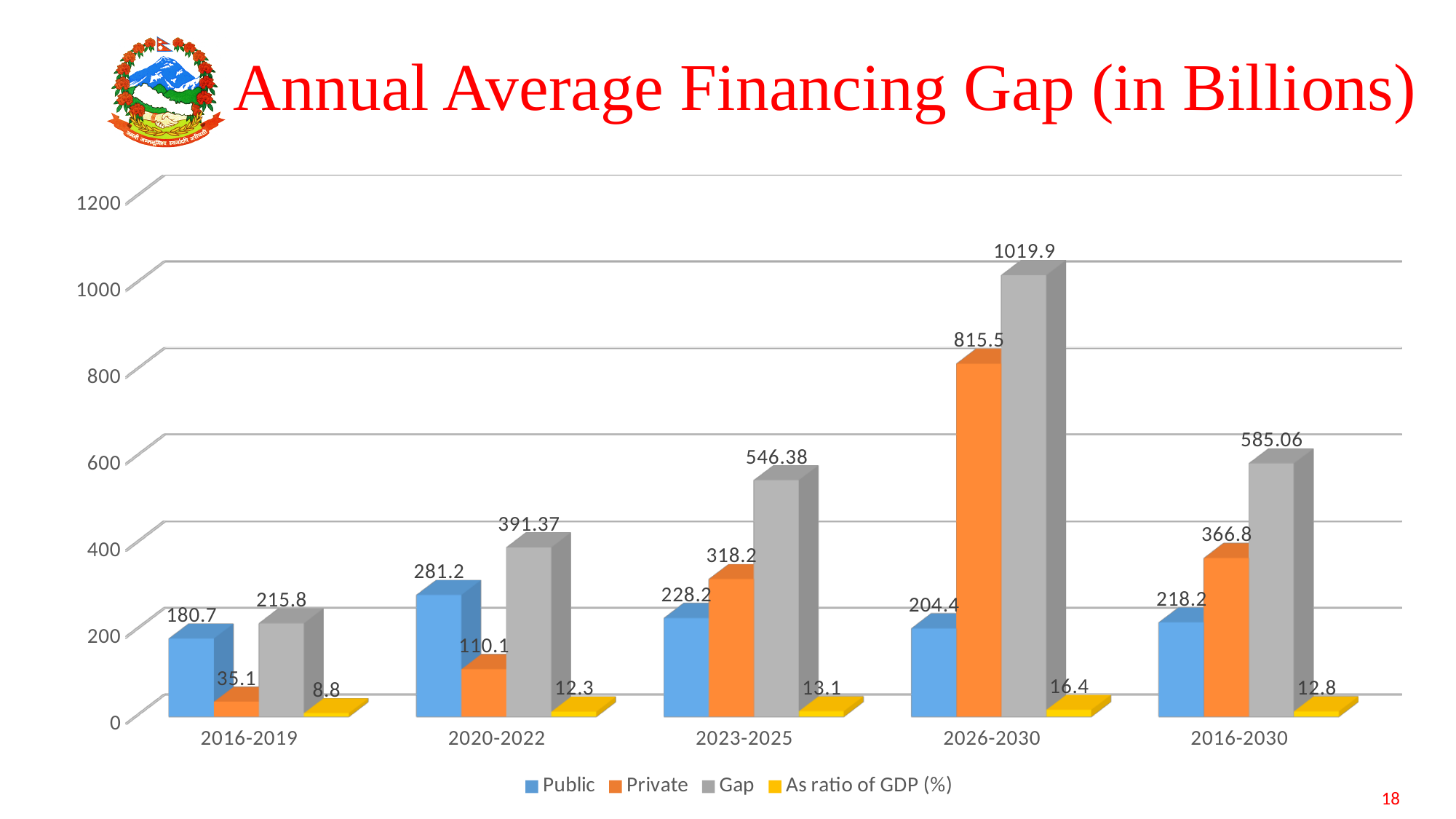
What is the 'As ratio of GDP (%)' value for 2016-2019? 8.8 Is the Private value for 2026-2030 greater or less than 800? greater What is the title of the chart? Annual Average Financing Gap (in Billions) Which period has the highest Gap value? 2026-2030 Which period has the lowest Private value? 2016-2019 Which is larger for 2023-2025, the Public value or the Private value? Private What is the Gap value for 2026-2030? 1019.9 How many periods are shown on the x axis? 5 What is the Private value for 2020-2022? 110.1 What kind of chart is shown on the slide? Bar chart How many series does the legend list? 4 What is the difference between the Gap and Public values for 2016-2030? 366.86